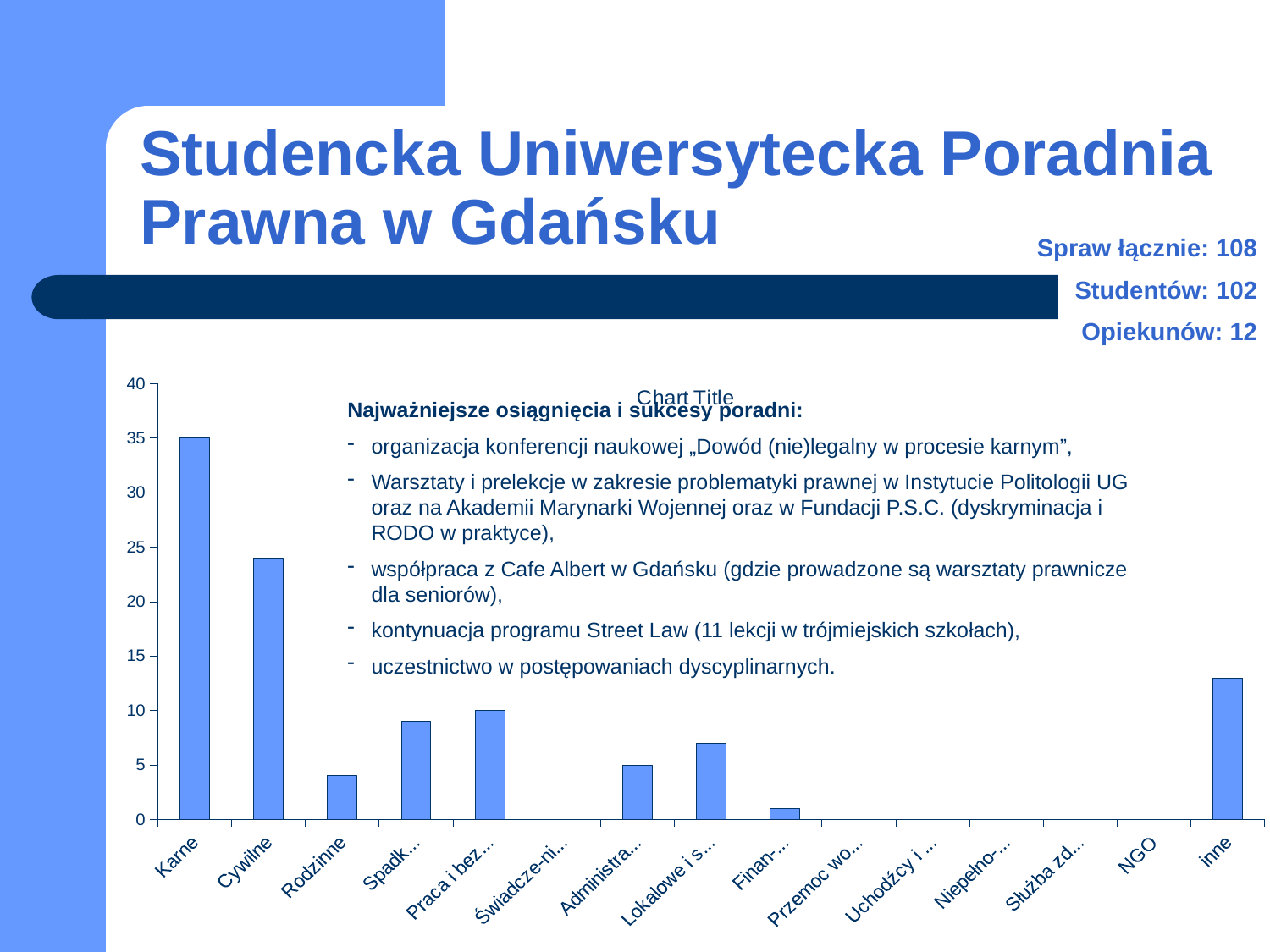
What type of chart is shown on the slide? bar chart How many categories are shown on the x axis? 15 What is the value for Karne? 35 Is the value for inne greater or less than 10? greater What is the title of the chart? Chart Title Is the value for Rodzinne greater or less than 5? less What is the value for Administra...? 5 Which is larger, the value for Cywilne or the value for inne? Cywilne What is the difference between the values for Karne and Praca i bez...? 25 Which category has the highest value? Karne What is the value for Praca i bez...? 10 Is the value for Cywilne greater or less than 20? greater